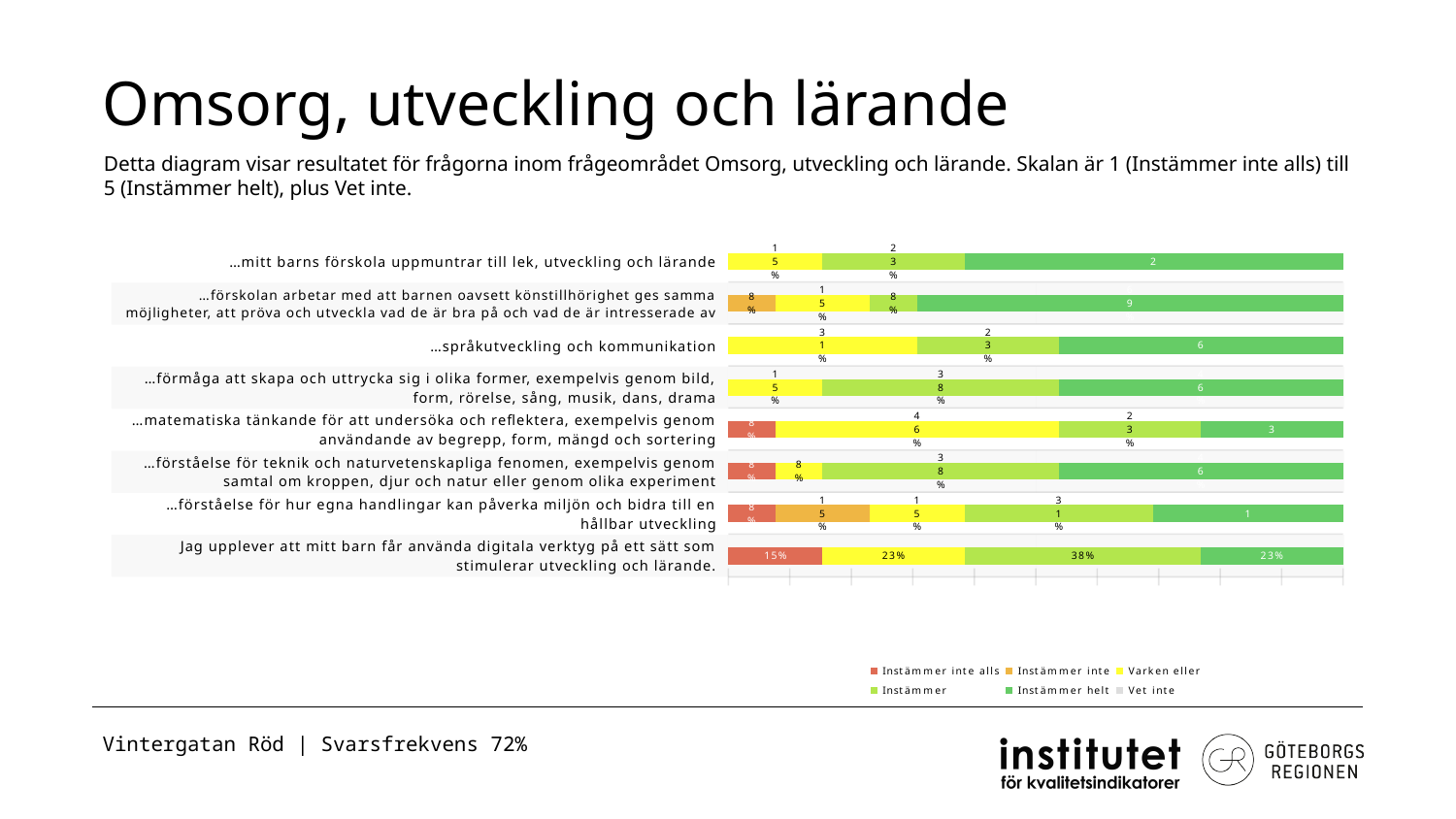
Which colour does the legend use for Instämmer inte alls? Red For the bar "Jag upplever att mitt barn får använda digitala verktyg på ett sätt som stimulerar utveckling och lärande.", what is the value for Instämmer helt? 23% For the bar "Jag upplever att mitt barn får använda digitala verktyg på ett sätt som stimulerar utveckling och lärande.", what is the value for Varken eller? 23% What kind of chart is shown on the slide? Stacked bar chart In the bar "Jag upplever att mitt barn får använda digitala verktyg...", what is the difference between Instämmer (38%) and Instämmer helt (23%)? 15 percentage points Which bar has the largest Instämmer inte alls (red) segment? Jag upplever att mitt barn får använda digitala verktyg på ett sätt som stimulerar utveckling och lärande. In the bar "Jag upplever att mitt barn får använda digitala verktyg...", which is larger: Instämmer or Instämmer helt? Instämmer For the bar "Jag upplever att mitt barn får använda digitala verktyg på ett sätt som stimulerar utveckling och lärande.", what is the value for Instämmer inte alls? 15% In the bar "Jag upplever att mitt barn får använda digitala verktyg...", which response category has the largest share? Instämmer How many question categories (bars) does the chart show? 8 For the bar "Jag upplever att mitt barn får använda digitala verktyg på ett sätt som stimulerar utveckling och lärande.", what is the value for Instämmer? 38% How many series does the legend list? 6